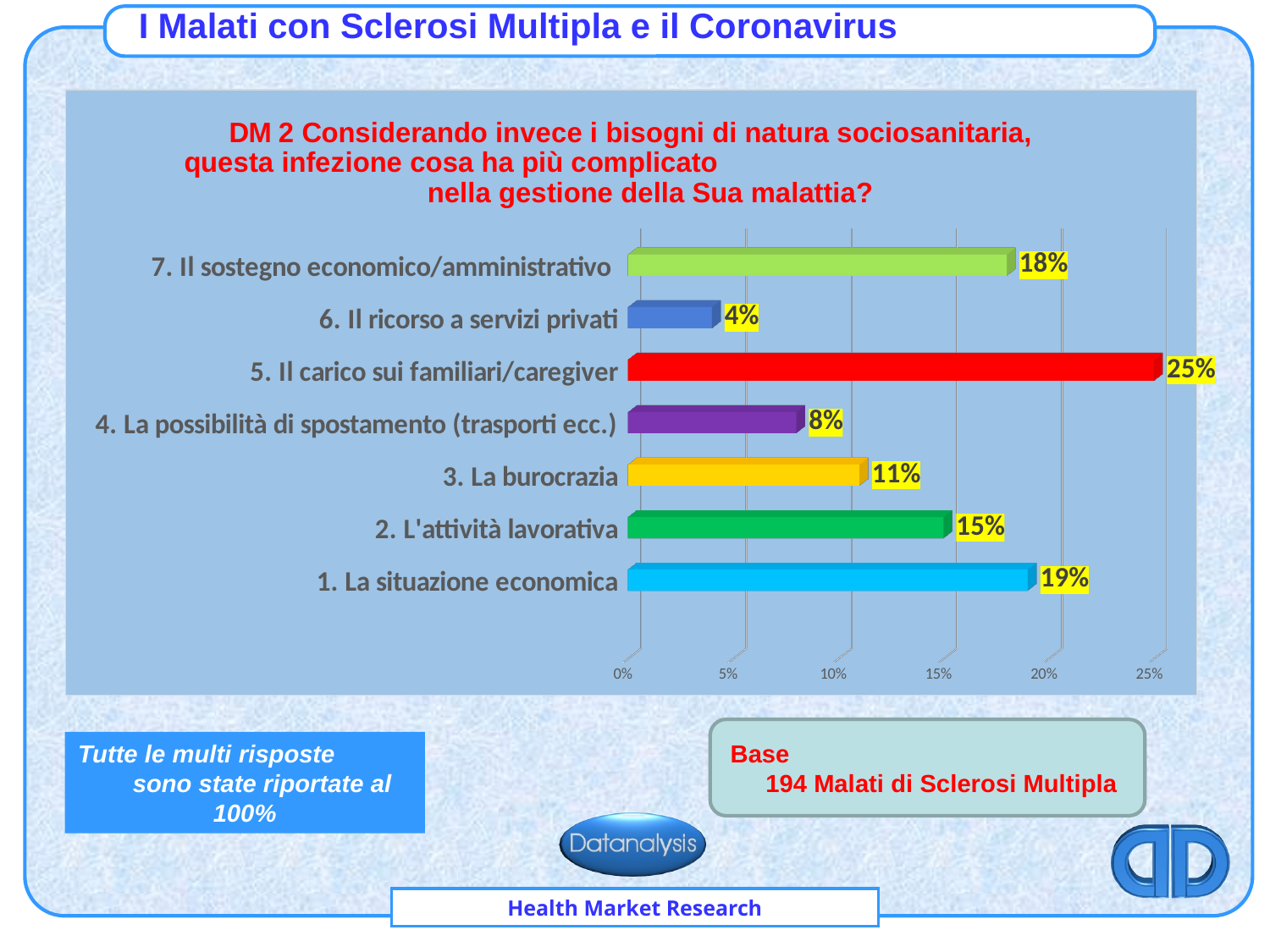
Which is larger, the value for "7. Il sostegno economico/amministrativo" or the value for "4. La possibilità di spostamento (trasporti ecc.)"? 7. Il sostegno economico/amministrativo Which category has the lowest value? 6. Il ricorso a servizi privati Is the value for "1. La situazione economica" greater or less than 15%? greater What kind of chart is shown on the slide? Bar chart What colour is the bar for "5. Il carico sui familiari/caregiver"? Red What is the value for "6. Il ricorso a servizi privati"? 4% What is the difference between the values for "1. La situazione economica" and "2. L'attività lavorativa"? 4% How many categories are shown in the chart? 7 What is the value for "3. La burocrazia"? 11% Which category has the highest value? 5. Il carico sui familiari/caregiver What is the value for "5. Il carico sui familiari/caregiver"? 25% What is the difference between the highest and lowest values in the chart? 21%